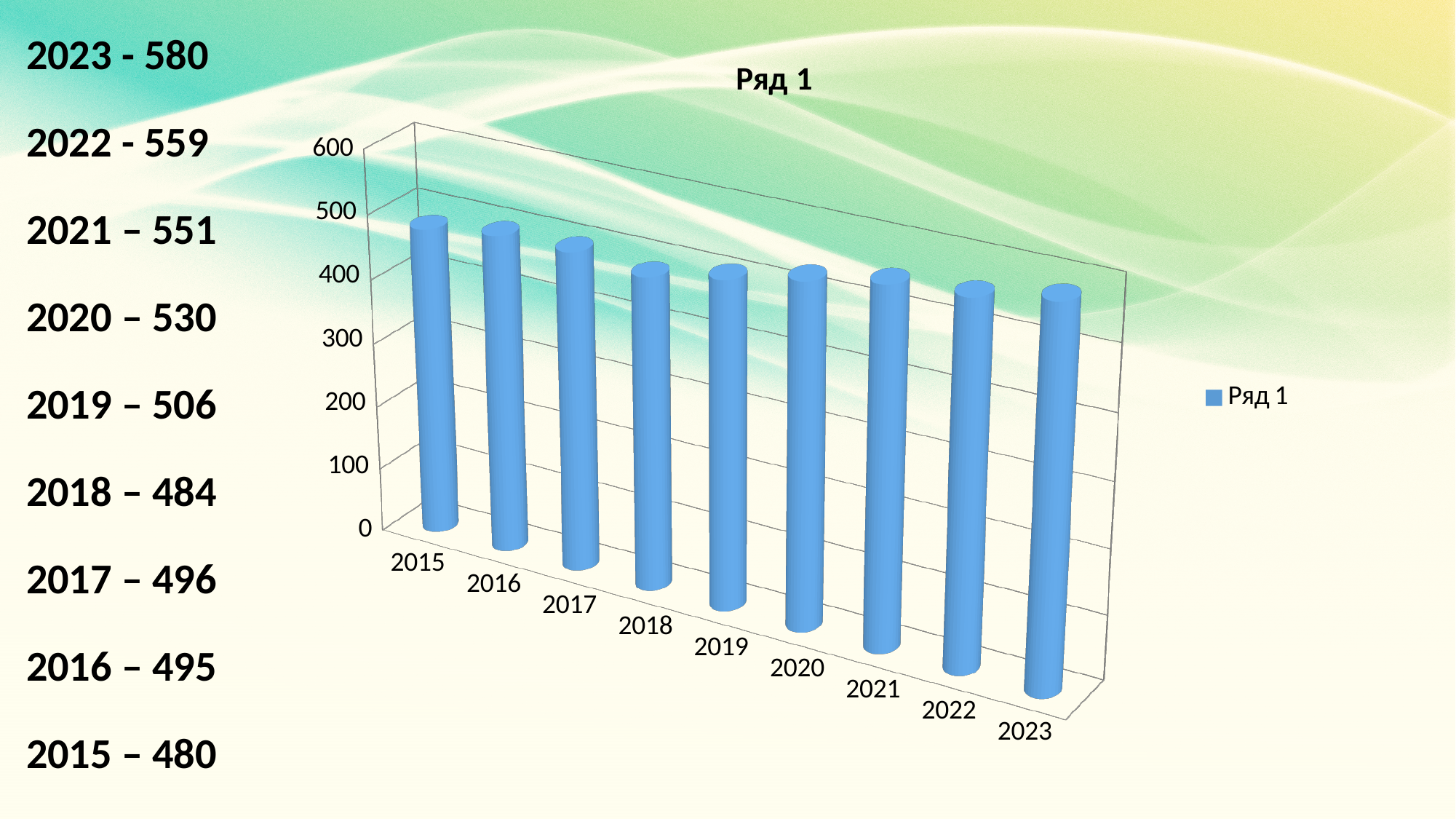
Is the value of the 2015 bar greater or less than 400? greater According to the values listed on the slide, which year has the highest value? 2023 According to the values listed on the slide, what is the value for 2019? 506 What kind of chart is shown on the slide? bar chart According to the values listed on the slide, what is the value for 2015? 480 What is the highest value shown on the chart's vertical axis? 600 According to the values listed on the slide, what is the value for 2023? 580 What is the title of the chart? Ряд 1 According to the values listed on the slide, what is the difference between the values for 2023 and 2015? 100 According to the values listed on the slide, which year has the lowest value? 2015 How many years (categories) are shown on the chart's x axis? 9 How many series does the chart's legend list? 1